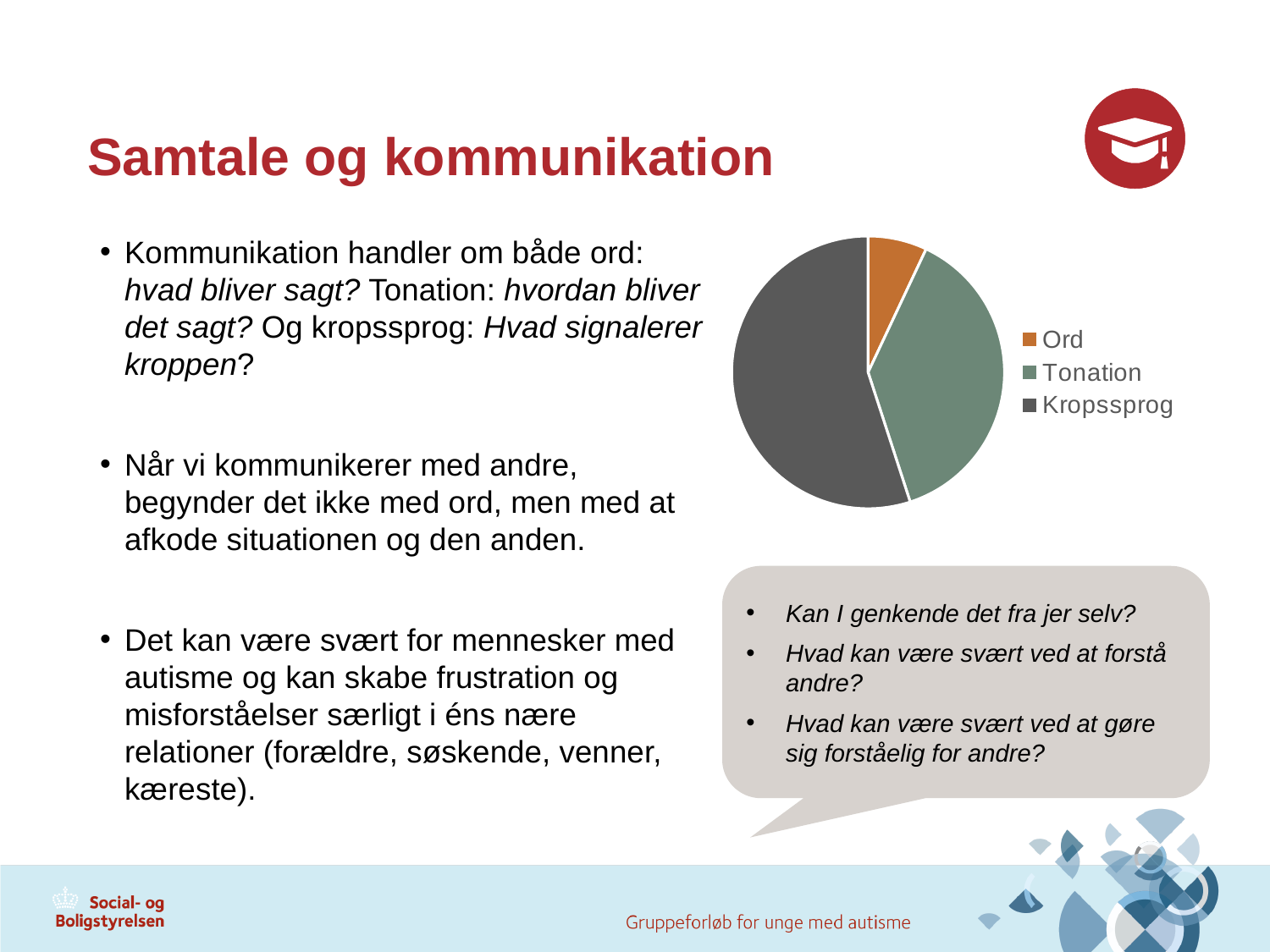
Which category is shown in dark grey in the pie chart? Kropssprog What colour is the Ord slice in the pie chart? orange Which category has the smallest slice in the pie chart? Ord How many entries does the legend of the pie chart list? 3 Which category has the largest slice in the pie chart? Kropssprog Which slice is larger in the pie chart, Ord or Kropssprog? Kropssprog Which slice is larger in the pie chart, Kropssprog or Tonation? Kropssprog What kind of chart is shown on the slide? pie chart How many slices does the pie chart have? 3 Which slice is larger in the pie chart, Tonation or Ord? Tonation